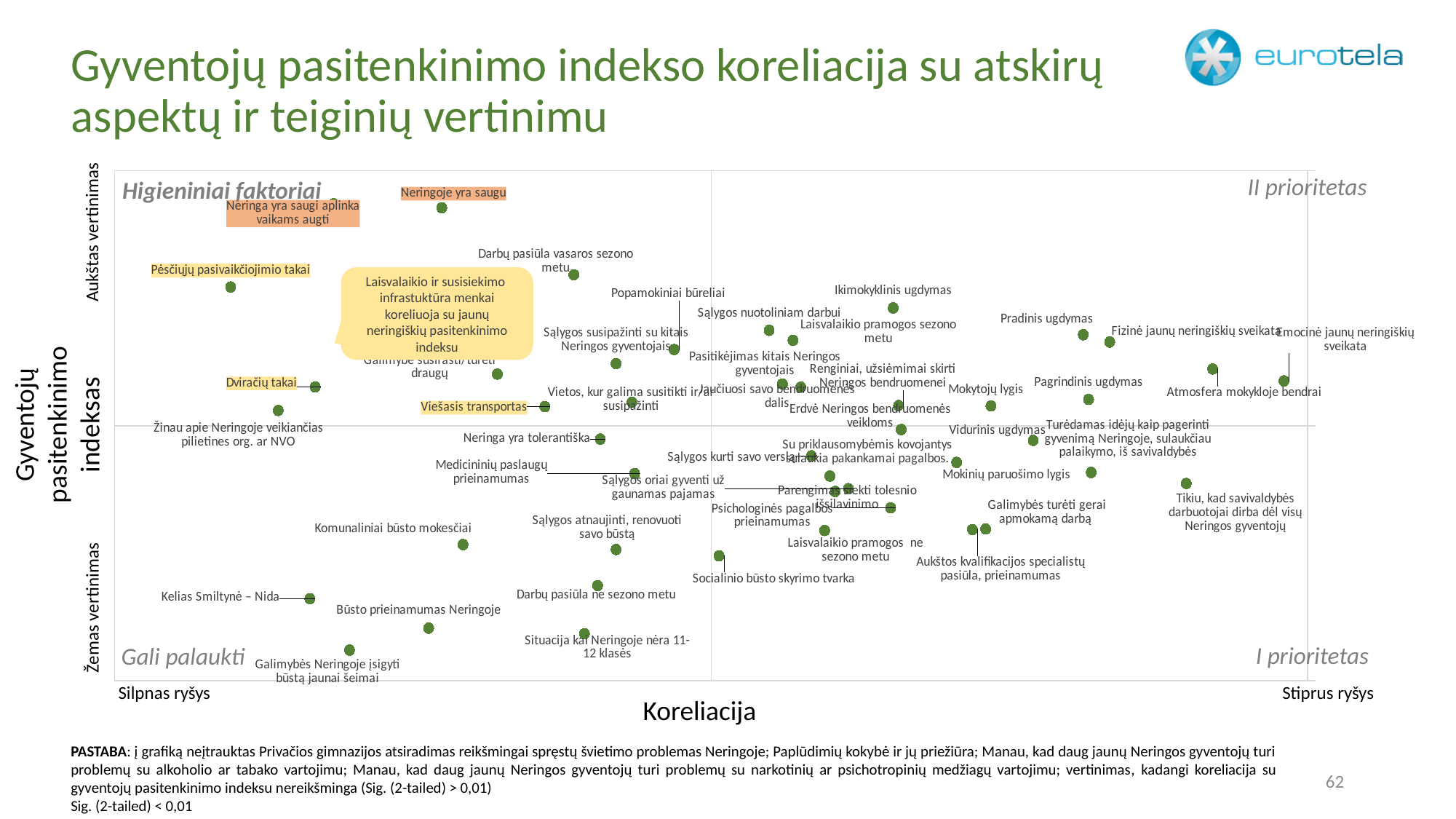
Which point is lowest on the chart (lowest satisfaction index rating)? Galimybės Neringoje įsigyti būstą jaunai šeimai Which is rated higher on the satisfaction index: 'Darbų pasiūla vasaros sezono metu' or 'Darbų pasiūla ne sezono metu'? Darbų pasiūla vasaros sezono metu Which point lies furthest to the right on the chart (strongest correlation)? Emocinė jaunų neringiškių sveikata In which quadrant of the chart is 'Tikiu, kad savivaldybės darbuotojai dirba dėl visų Neringos gyventojų' located? I prioritetas What is the label of the vertical axis of the chart? Gyventojų pasitenkinimo indeksas What kind of chart is shown on the slide? scatter chart How many quadrants is the chart divided into? 4 In which quadrant of the chart is 'Pradinis ugdymas' located? II prioritetas Which point lies furthest to the left on the chart (weakest correlation)? Pėsčiųjų pasivaikščiojimo takai In which quadrant of the chart is 'Komunaliniai būsto mokesčiai' located? Gali palaukti What is the label of the horizontal axis of the chart? Koreliacija Which has a stronger correlation: 'Kelias Smiltynė – Nida' or 'Pradinis ugdymas'? Pradinis ugdymas